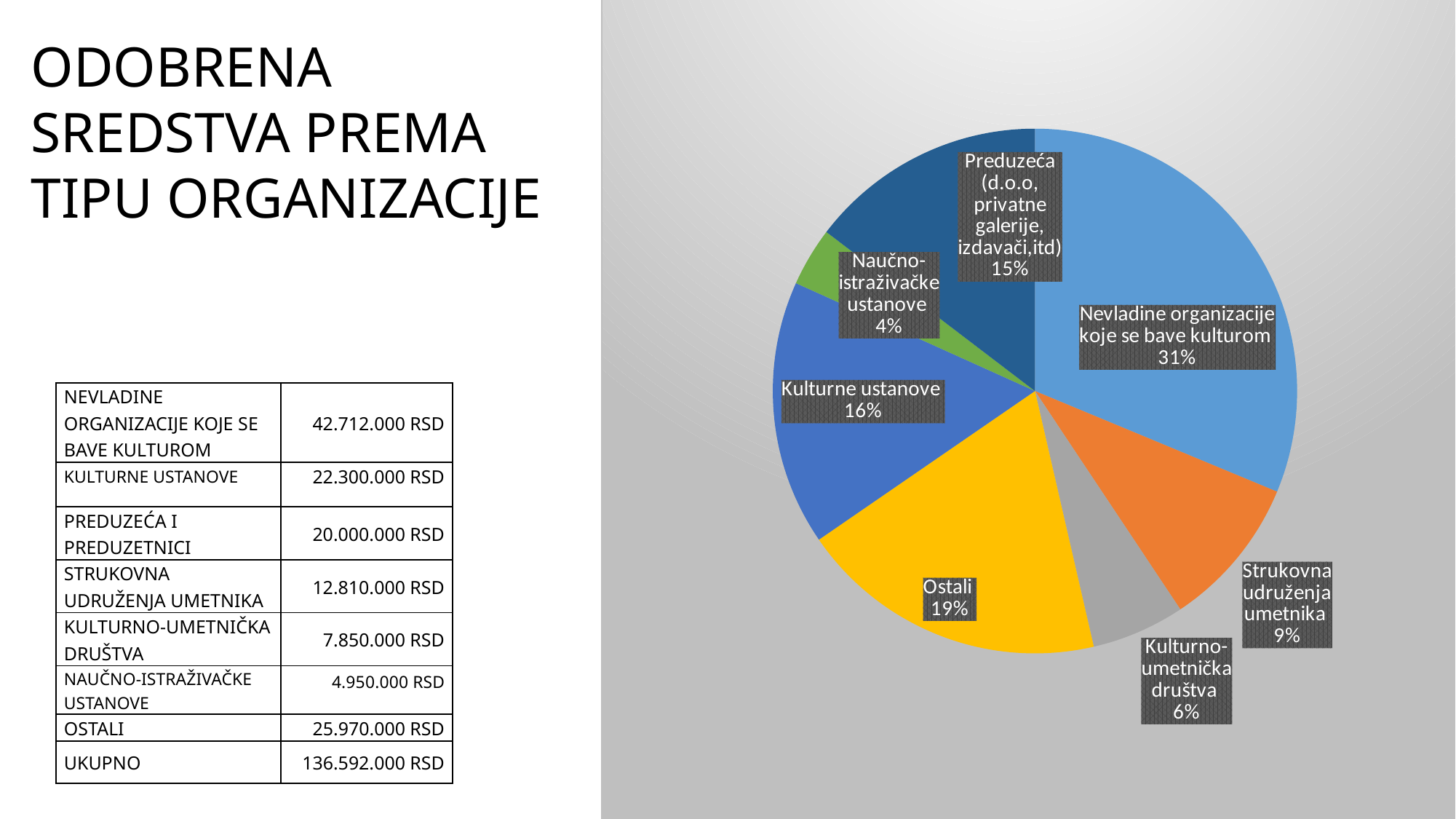
What is the difference in percentage points between "Ostali" and "Kulturne ustanove" in the pie chart? 3 What percentage is shown for "Naučno-istraživačke ustanove" in the pie chart? 4% What kind of chart is shown on the slide? pie chart Which category has the largest slice of the pie chart? Nevladine organizacije koje se bave kulturom What percentage is shown for "Ostali" in the pie chart? 19% What colour is the "Ostali" slice in the pie chart? yellow What share of the pie does "Nevladine organizacije koje se bave kulturom" have? 31% What percentage is shown for "Preduzeća (d.o.o, privatne galerije, izdavači,itd)" in the pie chart? 15% What percentage is shown for "Kulturne ustanove" in the pie chart? 16% Which slice is larger in the pie chart: "Strukovna udruženja umetnika" or "Kulturno-umetnička društva"? Strukovna udruženja umetnika How many slices does the pie chart have? 7 Which category has the smallest slice of the pie chart? Naučno-istraživačke ustanove